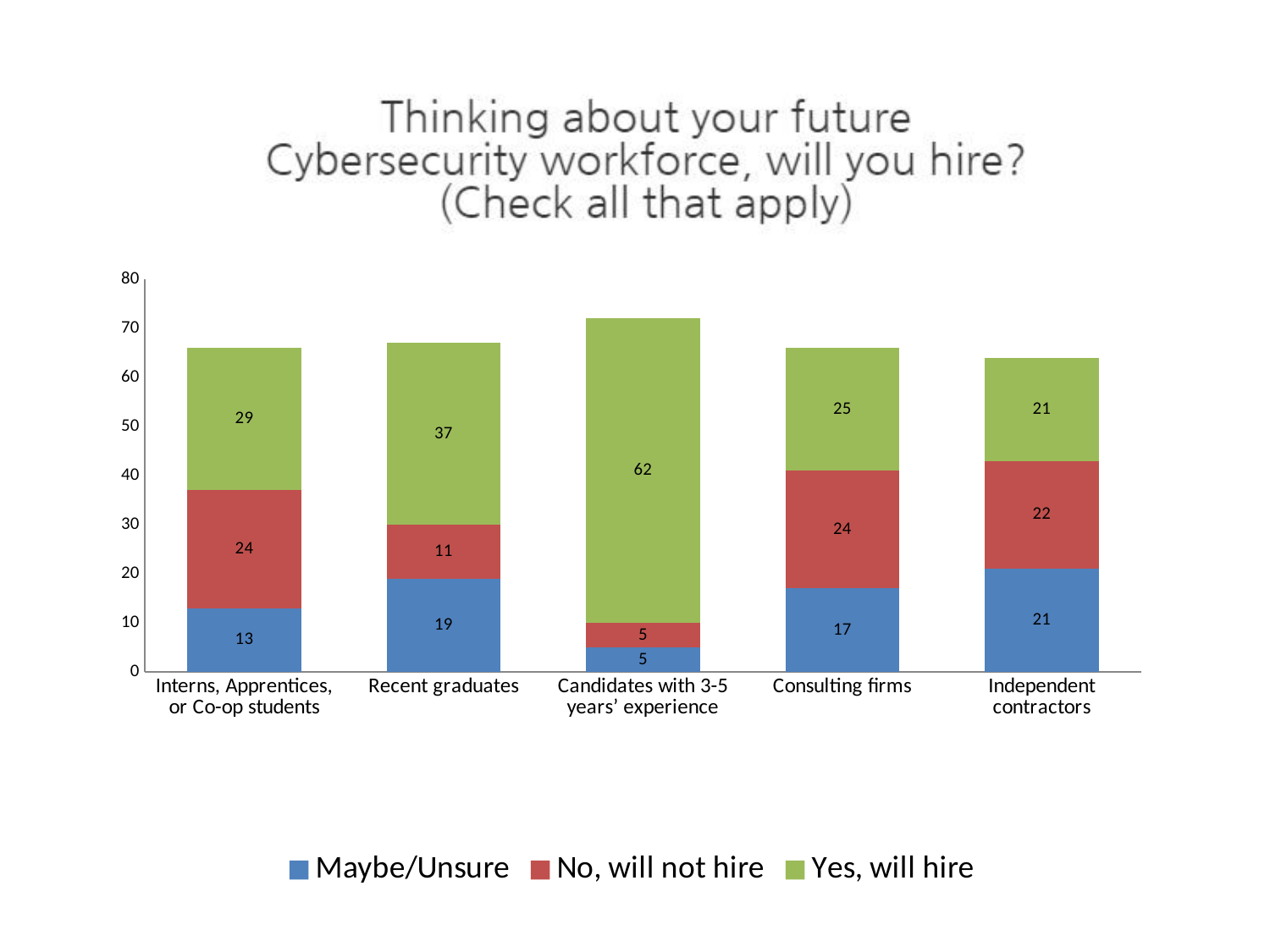
Which is larger: the "No, will not hire" value for Independent contractors or for Recent graduates? Independent contractors What is the total of the stacked bar for Independent contractors? 64 Which category has the lowest "Maybe/Unsure" value? Candidates with 3-5 years' experience How many categories are shown on the x axis? 5 What is the total of the stacked bar for Candidates with 3-5 years' experience? 72 What is the "Maybe/Unsure" value for Consulting firms? 17 What kind of chart is shown on the slide? Stacked bar chart How many series does the legend list? 3 What is the "Yes, will hire" value for Candidates with 3-5 years' experience? 62 What is the "No, will not hire" value for Recent graduates? 11 Which category has the highest "Yes, will hire" value? Candidates with 3-5 years' experience What is the difference between the "Yes, will hire" values for Recent graduates and Interns, Apprentices, or Co-op students? 8